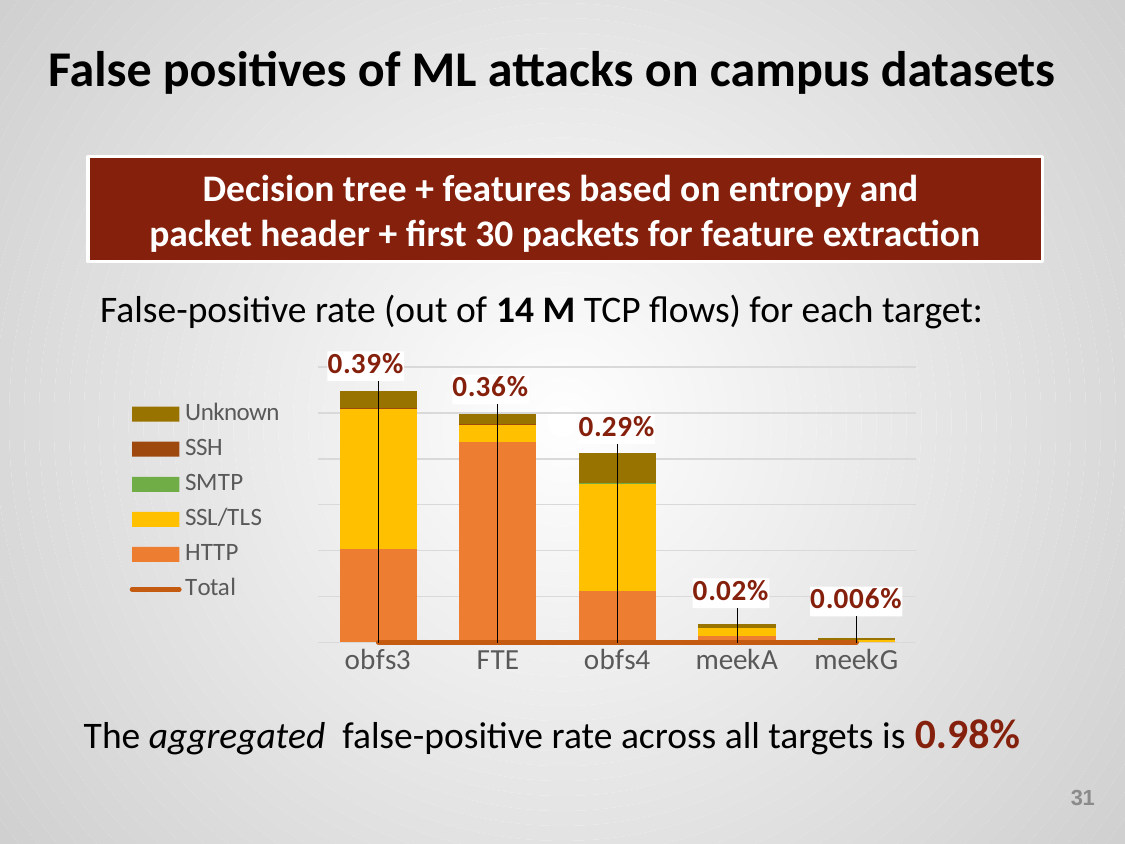
Which has a larger total false-positive rate, FTE or meekA? FTE Which target has the lowest total false-positive rate? meekG How many targets are shown on the x axis of the chart? 5 Which target has the highest total false-positive rate? obfs3 What kind of chart is used to show the false-positive rates? A stacked bar chart combined with a line series for the total What is the total false-positive rate for meekG? 0.006% How many entries does the chart's legend list? 6 What is the total false-positive rate for meekA? 0.02% What is the total false-positive rate for obfs4? 0.29% What is the total false-positive rate for FTE? 0.36% What is the difference between the total false-positive rates of obfs3 and obfs4? 0.10% What is the total false-positive rate for obfs3? 0.39%